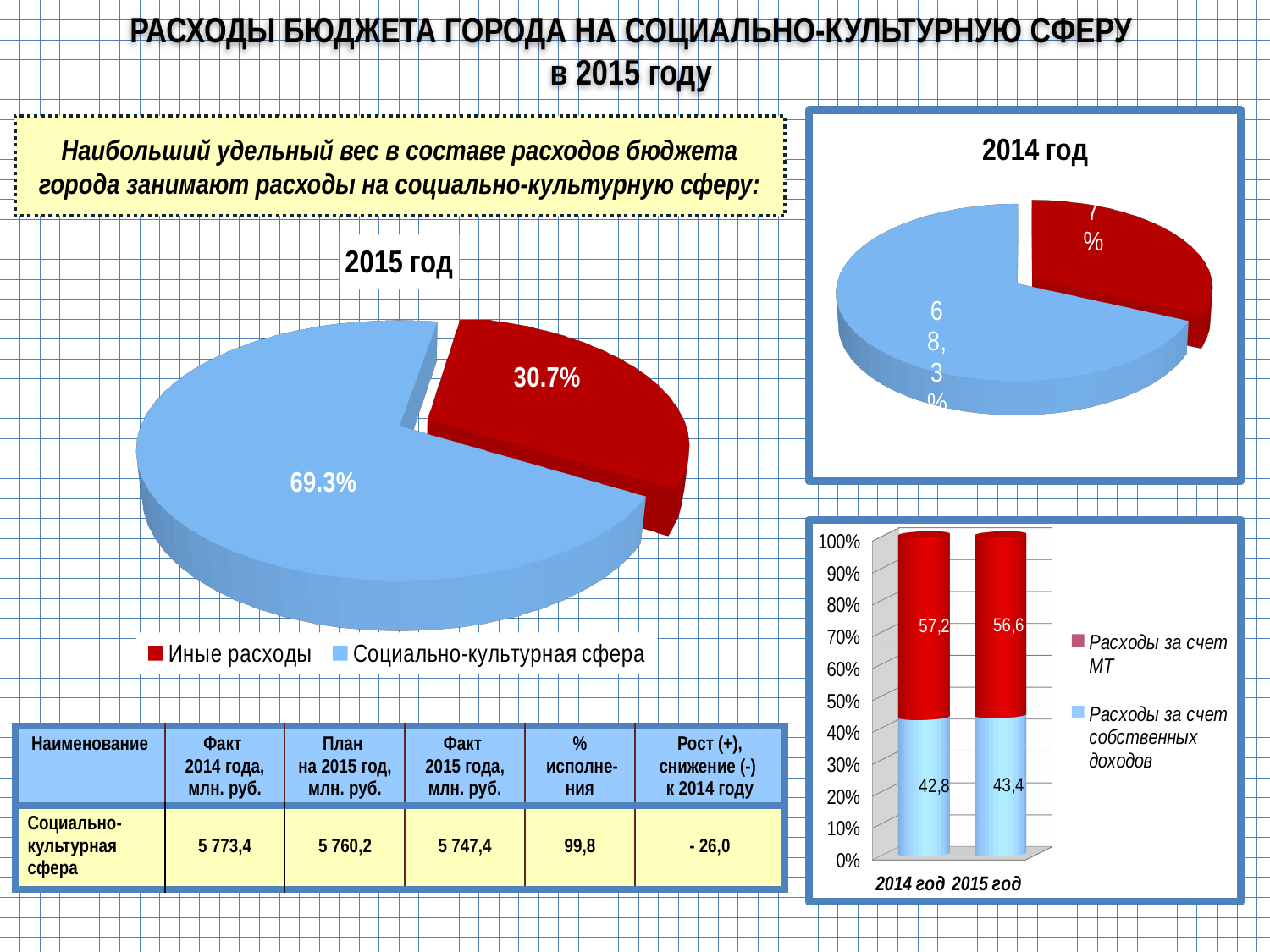
In the stacked bar chart at the bottom right, how many bars are plotted? 2 What kind of chart is the 2015 год chart? Pie chart In the stacked bar chart at the bottom right, what is the value for Расходы за счет собственных доходов in 2014 год? 42,8 In the 2015 год pie chart, which category has the larger slice? Социально-культурная сфера How many entries does the legend of the 2015 год pie chart list? 2 In the 2015 год pie chart, what share is shown for Социально-культурная сфера? 69.3% In the stacked bar chart at the bottom right, what is the value for Расходы за счет МТ in 2015 год? 56,6 In the stacked bar chart at the bottom right, what is the total of the 2015 год bar? 100 In the 2014 год pie chart, is the blue slice larger or smaller than the red slice? Larger In the 2015 год pie chart, what share is shown for Иные расходы? 30.7% In the 2015 год pie chart, what is the difference between the Социально-культурная сфера share and the Иные расходы share? 38.6% In the stacked bar chart at the bottom right, what is the difference between the Расходы за счет МТ values for 2014 год and 2015 год? 0,6